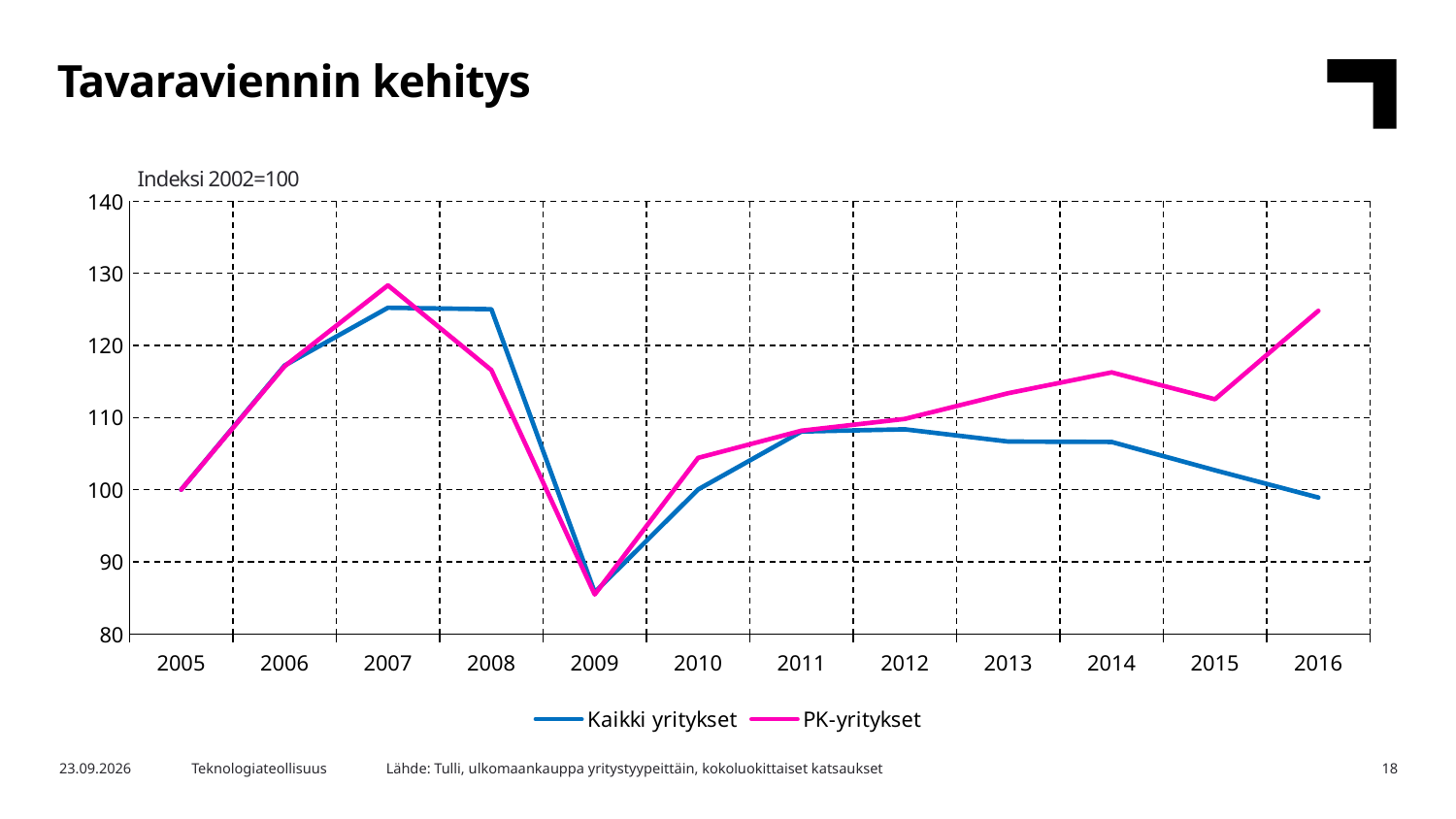
What is the title of the chart on the slide? Tavaraviennin kehitys Is the value for Kaikki yritykset in 2009 greater or less than 90? less How many years are plotted along the x axis? 12 Is the value for PK-yritykset in 2016 greater or less than 120? greater In which year does the PK-yritykset series reach its lowest value? 2009 In which year does the PK-yritykset series reach its highest value? 2007 Is the value for Kaikki yritykset in 2016 greater or less than 110? less Does the Kaikki yritykset series rise or fall from 2012 to 2016? Fall How many series does the legend list? 2 In 2008, which series has the higher value, Kaikki yritykset or PK-yritykset? Kaikki yritykset In 2016, which series has the higher value, Kaikki yritykset or PK-yritykset? PK-yritykset What kind of chart is shown on the slide? Line chart